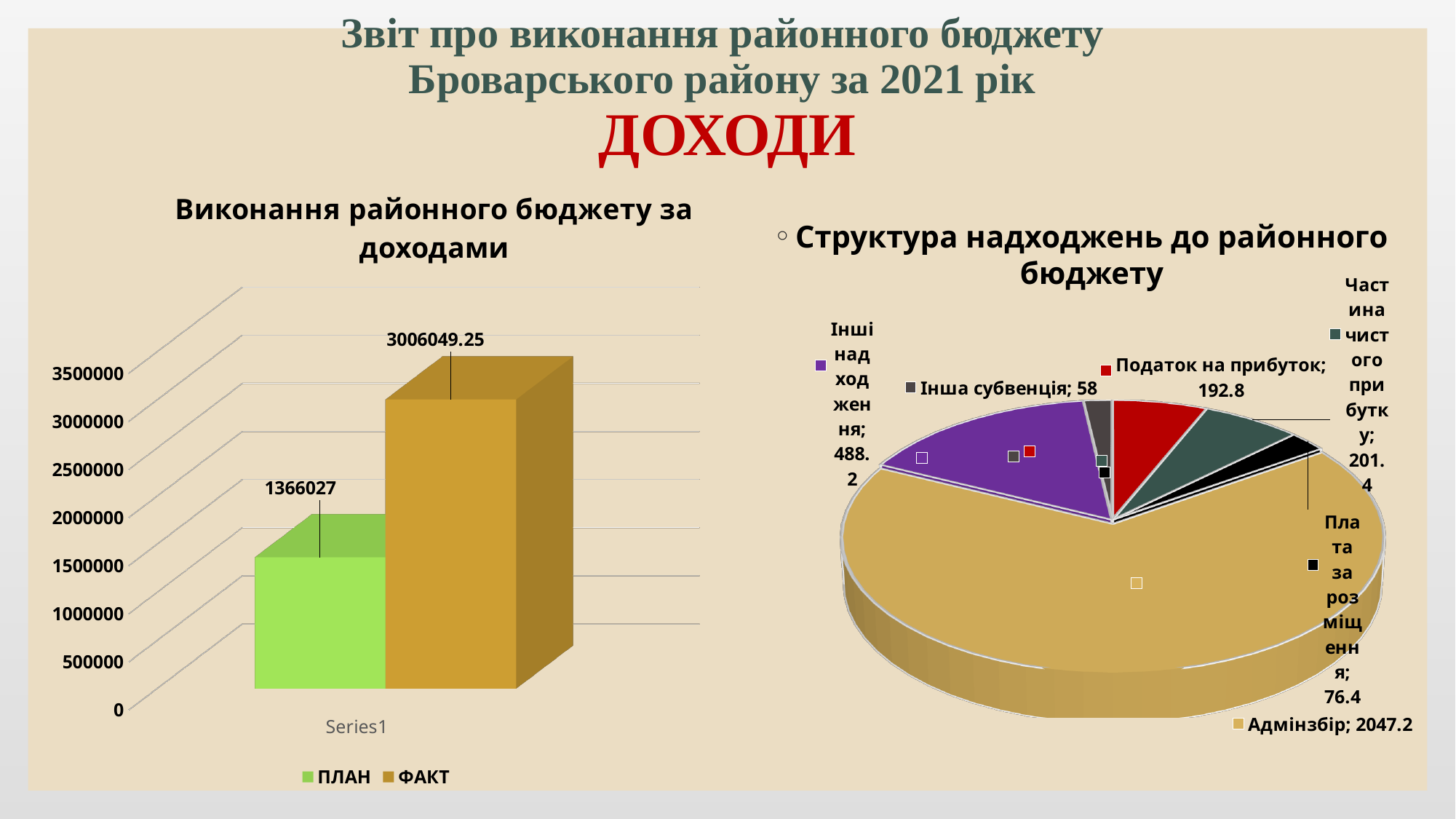
In the bar chart 'Виконання районного бюджету за доходами', what is the value for ФАКТ? 3006049.25 In the bar chart 'Виконання районного бюджету за доходами', which is larger, ПЛАН or ФАКТ? ФАКТ How many series does the legend of the bar chart 'Виконання районного бюджету за доходами' list? 2 In the pie chart 'Структура надходжень до районного бюджету', what is the value for Адмінзбір? 2047.2 What kind of chart is the right chart 'Структура надходжень до районного бюджету'? pie chart In the pie chart 'Структура надходжень до районного бюджету', which category has the largest value? Адмінзбір In the pie chart 'Структура надходжень до районного бюджету', what is the value for Податок на прибуток? 192.8 How many slices does the pie chart 'Структура надходжень до районного бюджету' have? 6 In the bar chart 'Виконання районного бюджету за доходами', what is the difference between ФАКТ and ПЛАН? 1640022.25 What kind of chart is the left chart 'Виконання районного бюджету за доходами'? bar chart In the bar chart 'Виконання районного бюджету за доходами', what is the value for ПЛАН? 1366027 In the pie chart 'Структура надходжень до районного бюджету', which category has the smallest value? Інша субвенція